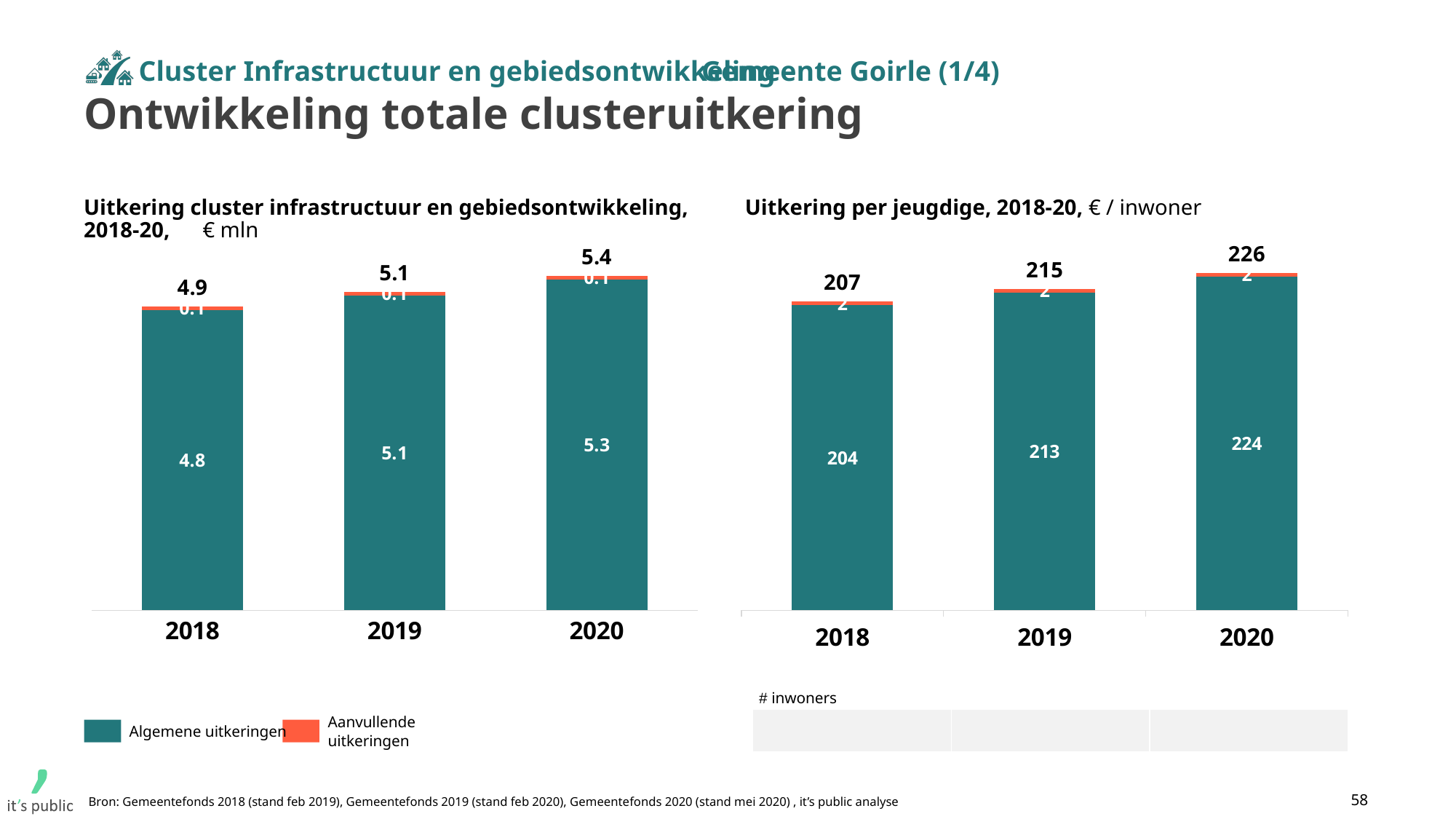
In the left chart, what is the difference between the total for 2020 and the total for 2018? 0.5 In the right chart, which year has the lowest total? 2018 How many series does the legend list? 2 In the left chart, what is the value of Aanvullende uitkeringen for 2019? 0.1 In the right chart (Uitkering per jeugdige), what is the total value for 2019? 215 What kind of chart is the left chart? stacked bar chart In the right chart, what is the difference between the total for 2020 and the total for 2018? 19 In the left chart, which year has the highest total? 2020 In the right chart, do the totals rise or fall from 2018 to 2020? rise In the left chart (Uitkering cluster infrastructuur en gebiedsontwikkeling), what is the total value for 2020? 5.4 In the left chart, what is the value of Algemene uitkeringen for 2018? 4.8 In the right chart, what is the value of Algemene uitkeringen for 2020? 224